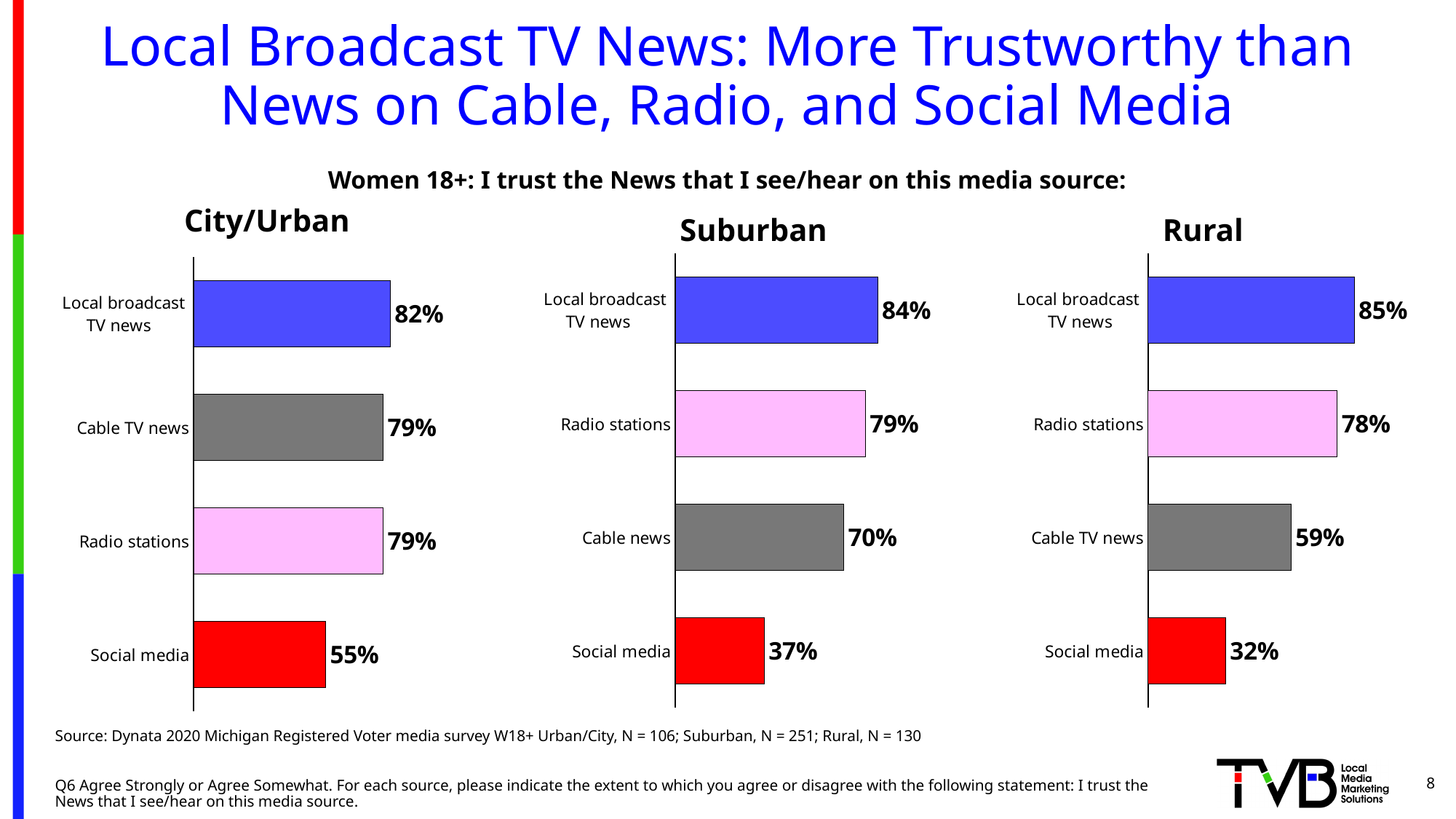
In the Rural chart, what is the value for Cable TV news? 59% What colour is the Social media bar in the Rural chart? red In the Rural chart, which category has the highest value? Local broadcast TV news In the Rural chart, which is larger: Radio stations or Cable TV news? Radio stations How many categories are shown in the Suburban chart? 4 In the Suburban chart, what is the difference between Radio stations and Cable news? 9% In the Suburban chart, which category has the lowest value? Social media In the City/Urban chart, what is the difference between Local broadcast TV news and Social media? 27% In the City/Urban chart, what is the value for Local broadcast TV news? 82% In the Suburban chart, what is the value for Social media? 37% What kind of chart is the City/Urban chart? bar chart In the Rural chart, what is the value for Social media? 32%